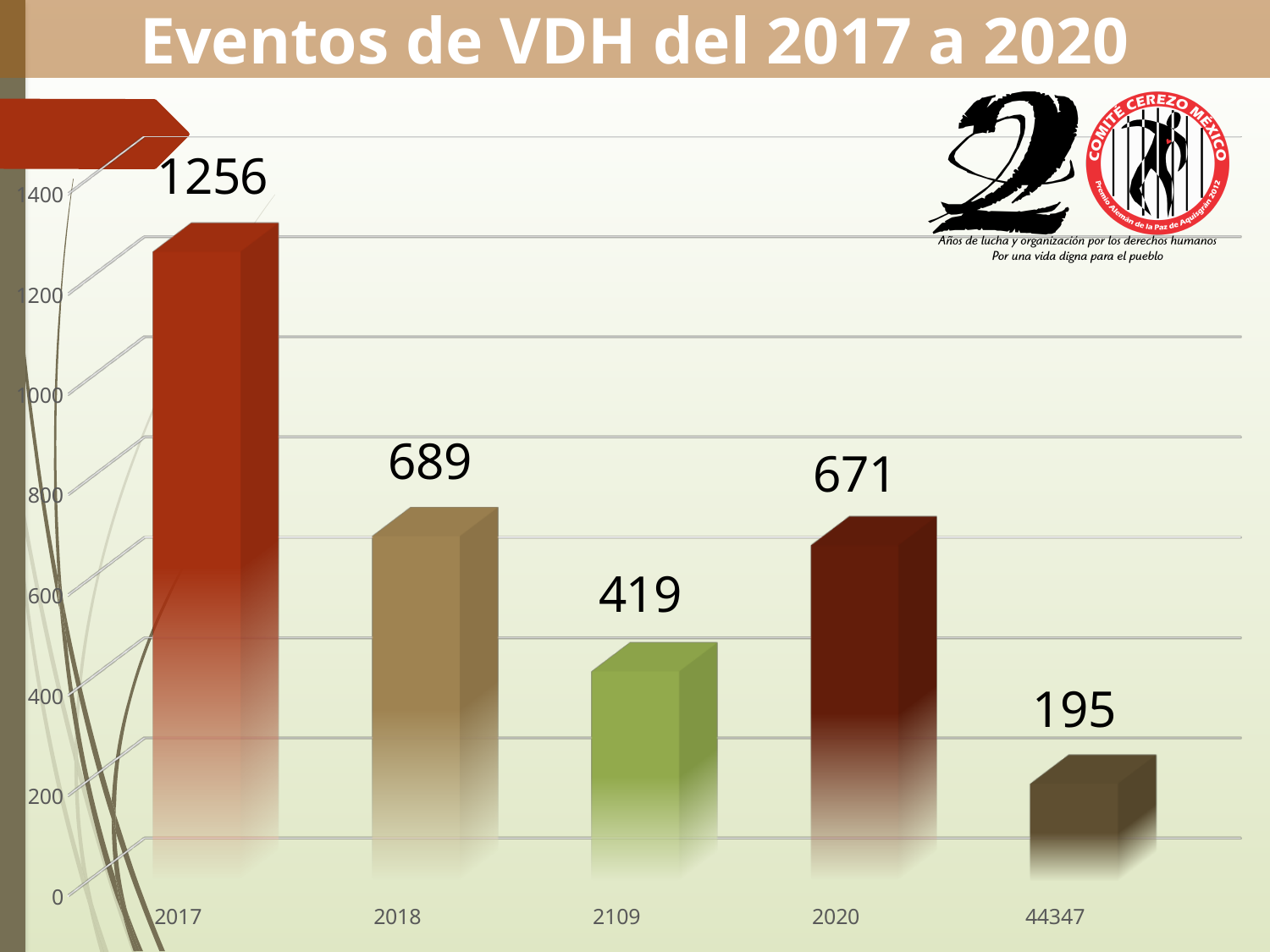
How many categories are shown on the x axis? 5 Which category has the highest value? 2017 What kind of chart is shown on the slide? Bar chart Which is larger, the value for 2018 or the value for 2020? 2018 What is the value for 2018? 689 What is the title of the slide? Eventos de VDH del 2017 a 2020 What is the value for 2017? 1256 Which category has the lowest value? 44347 What is the value for 2020? 671 What is the value for the category labelled 2109? 419 What is the value for the category labelled 44347? 195 What is the difference between the values for 2017 and 2018? 567